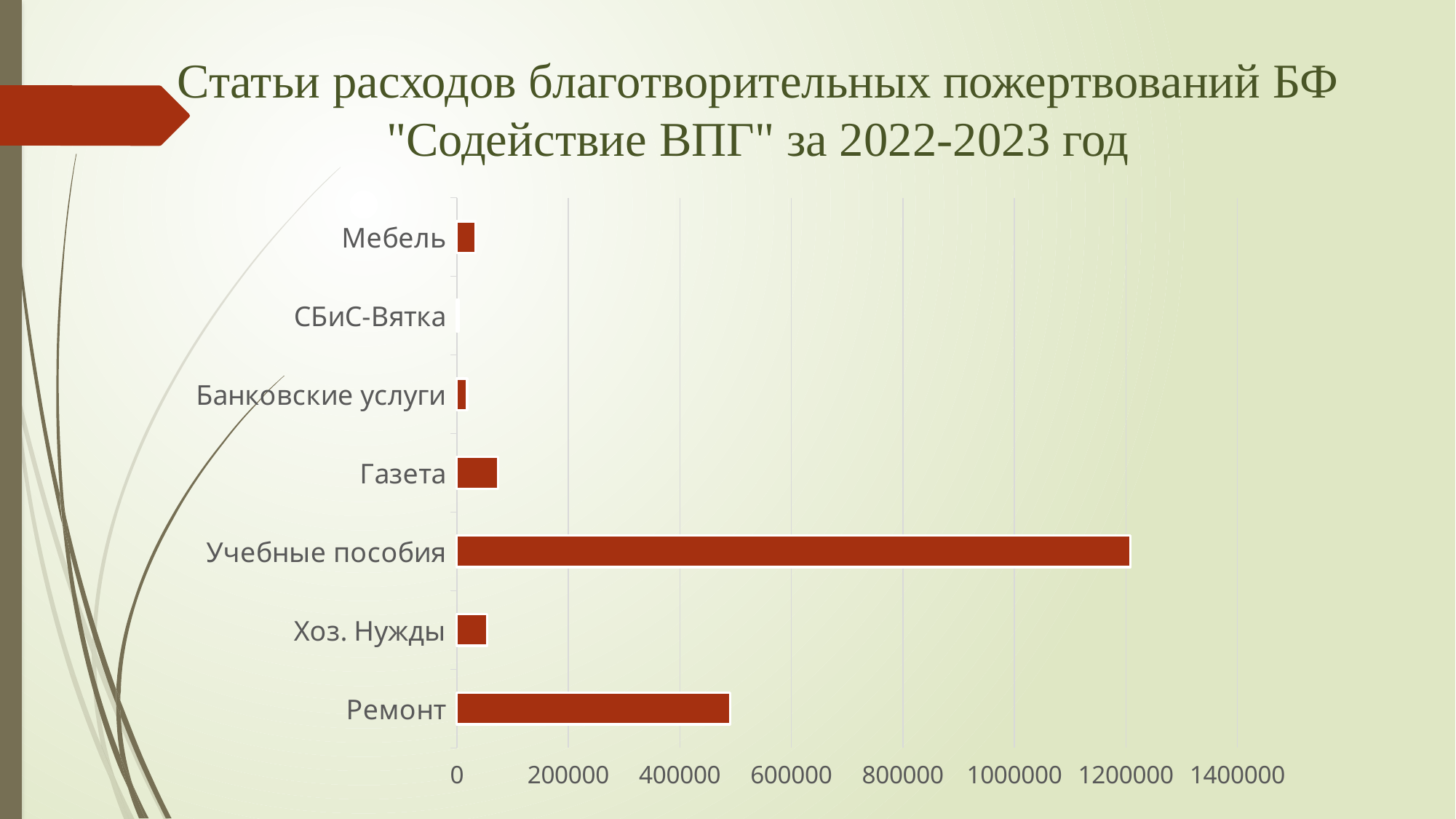
How many categories are plotted in the chart? 7 Is the value for Учебные пособия greater or less than 1000000? greater Which category has the lowest value? СБиС-Вятка Which is larger, the value for Учебные пособия or the value for Ремонт? Учебные пособия Is the value for Газета greater or less than 200000? less Is the value for Ремонт greater or less than 400000? greater Which is larger, the value for Ремонт or the value for Газета? Ремонт What kind of chart is shown on the slide? bar chart Which is larger, the value for Газета or the value for Мебель? Газета What is the title of the slide containing the chart? Статьи расходов благотворительных пожертвований БФ "Содействие ВПГ" за 2022-2023 год Which category has the highest value? Учебные пособия